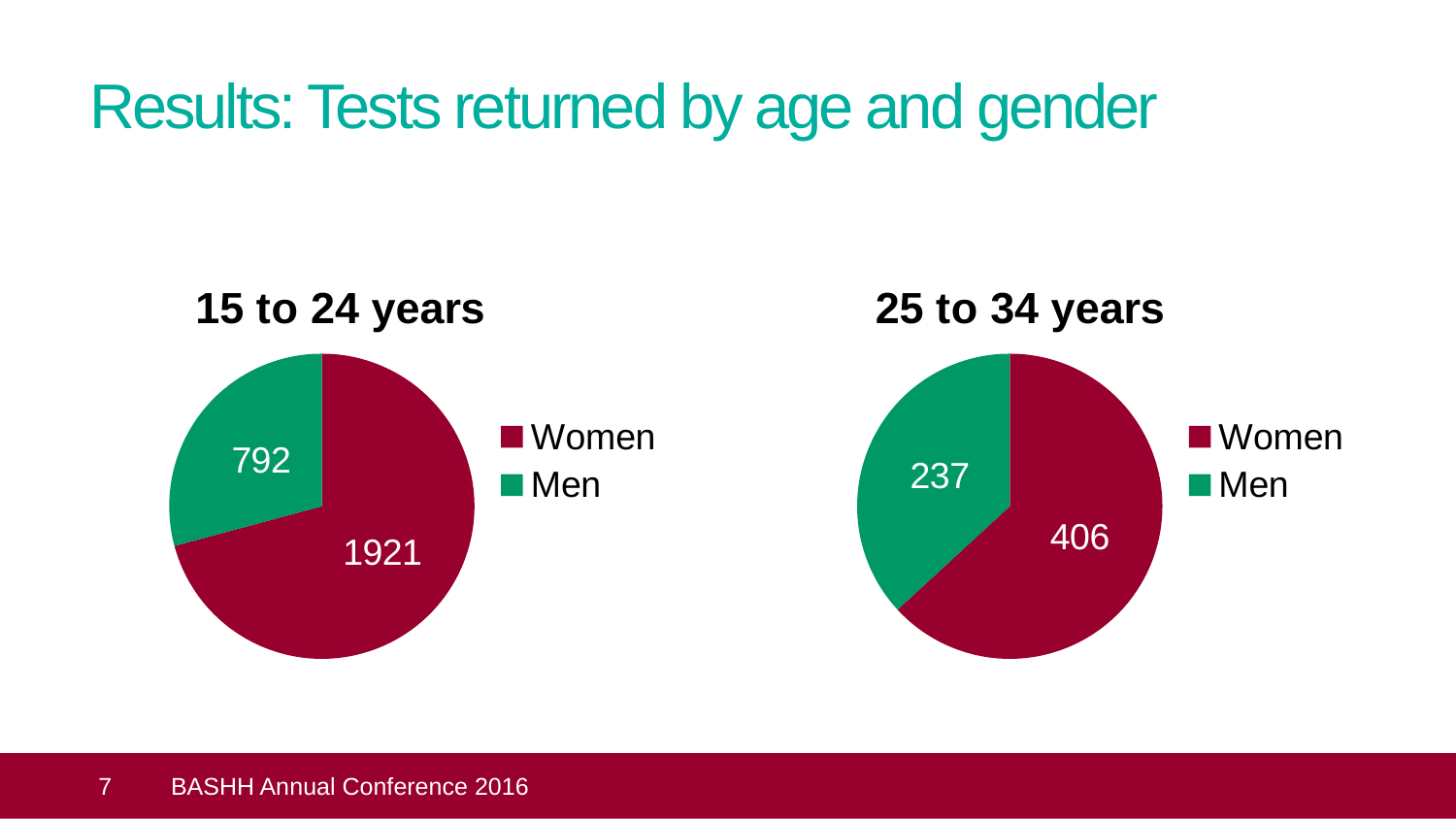
In the '15 to 24 years' chart, what is the difference between the number of tests returned by women and by men? 1129 What type of chart is used for the '15 to 24 years' data? Pie chart In the '25 to 34 years' chart, which group has the smaller slice? Men In the '15 to 24 years' chart, how many tests were returned by men? 792 In the '25 to 34 years' chart, what is the difference between the number of tests returned by women and by men? 169 In the '25 to 34 years' chart, how many tests were returned by men? 237 In the '25 to 34 years' chart, how many tests were returned by women? 406 In the '15 to 24 years' chart, which group has the larger slice? Women In the '15 to 24 years' chart, how many tests were returned by women? 1921 How many series does the legend of the '25 to 34 years' chart list? 2 In the '15 to 24 years' chart, what is the total number of tests returned across both groups? 2713 Which is larger: the number of tests returned by men aged 15 to 24 or by women aged 25 to 34? Men aged 15 to 24 (792)